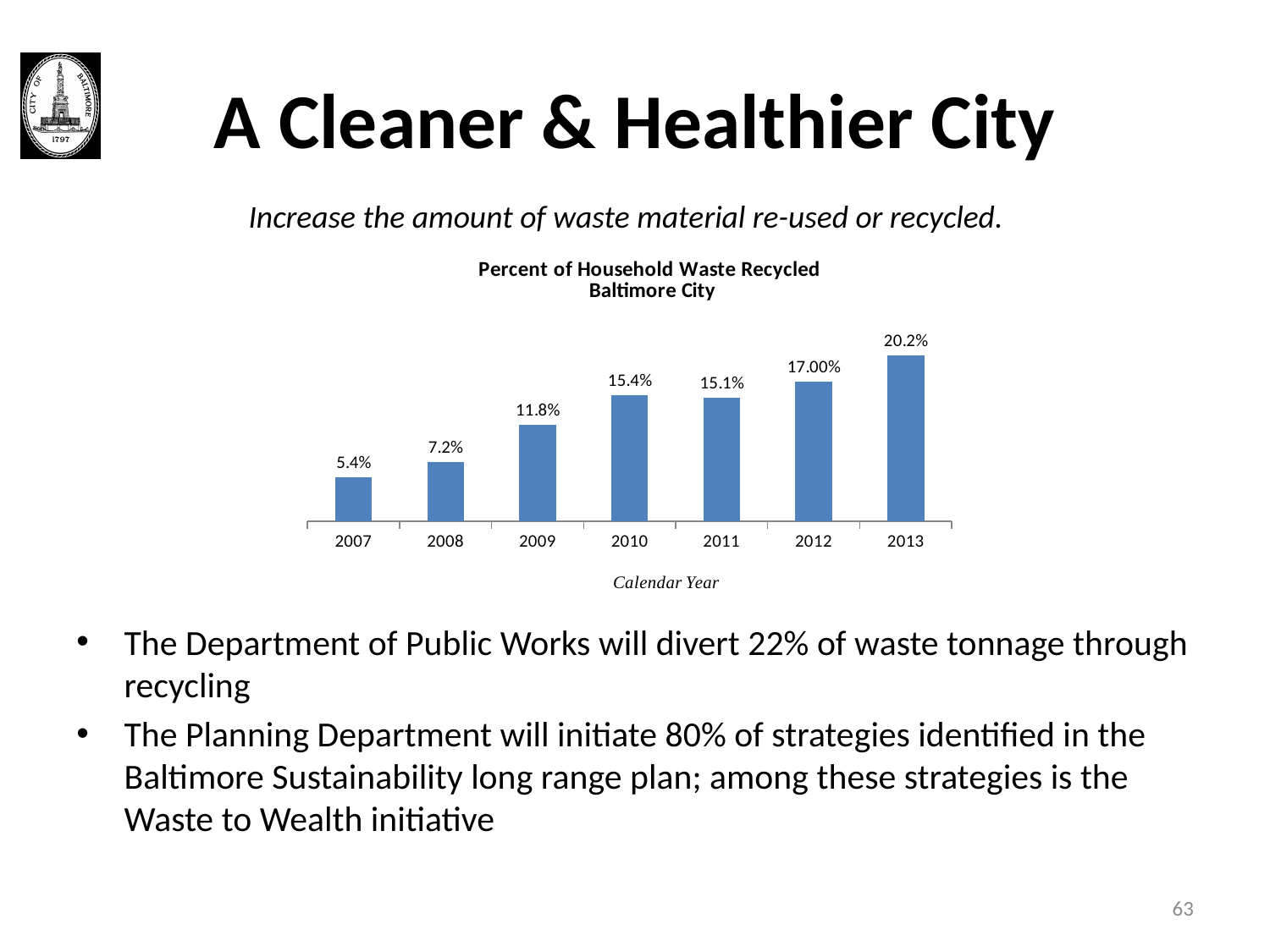
What is the difference in percent of household waste recycled between 2010 and 2009? 3.6% Which year has the lowest percent of household waste recycled? 2007 What is the percent of household waste recycled in 2009? 11.8% What is the title of the chart? Percent of Household Waste Recycled Baltimore City What is the percent of household waste recycled in 2012? 17.00% Does the percent of household waste recycled generally rise or fall from 2007 to 2013? Rise Which year has a higher percent of household waste recycled, 2010 or 2011? 2010 How many years are shown in the chart? 7 What is the difference in percent of household waste recycled between 2013 and 2007? 14.8% What kind of chart is shown on the slide? Bar chart What is the percent of household waste recycled in 2007? 5.4% Which year has the highest percent of household waste recycled? 2013